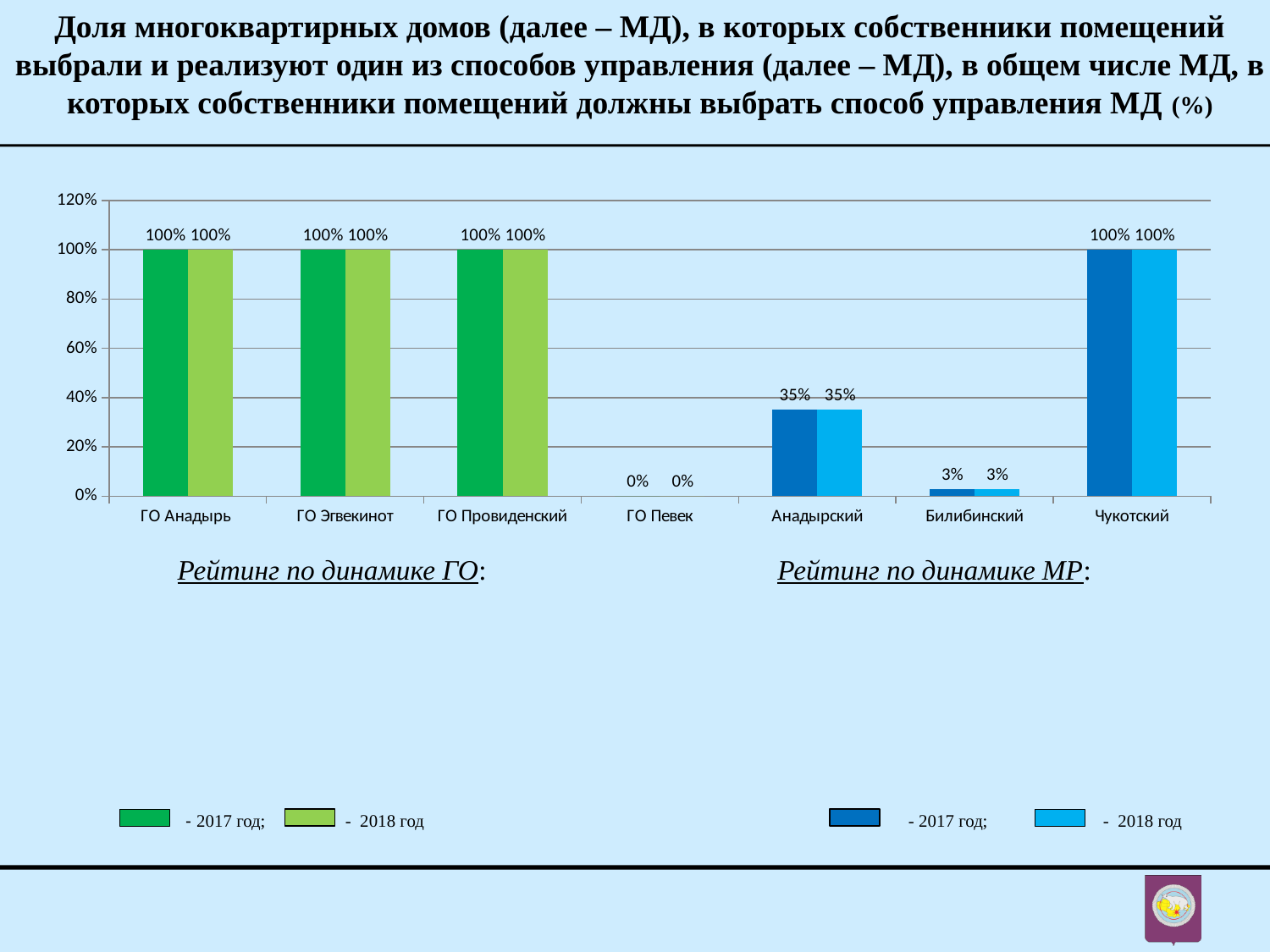
Is the 2018 value for Анадырский greater or less than 40%? less Which category has the lowest values in the chart? ГО Певек What colour are the bars for the ГО categories (ГО Анадырь, ГО Эгвекинот, ГО Провиденский, ГО Певек)? green What is the difference between the 2018 values for Анадырский and Билибинский? 32% What kind of chart is shown on the slide? bar chart What is the value for Чукотский in 2017? 100% How many categories are shown on the x axis of the chart? 7 Which is larger, the 2017 value for Анадырский or the 2017 value for Билибинский? Анадырский What is the value for Билибинский in 2017? 3% Which two years does the legend list for each group of bars? 2017 and 2018 What is the value for ГО Певек in 2018? 0% What is the value for Анадырский in 2018? 35%